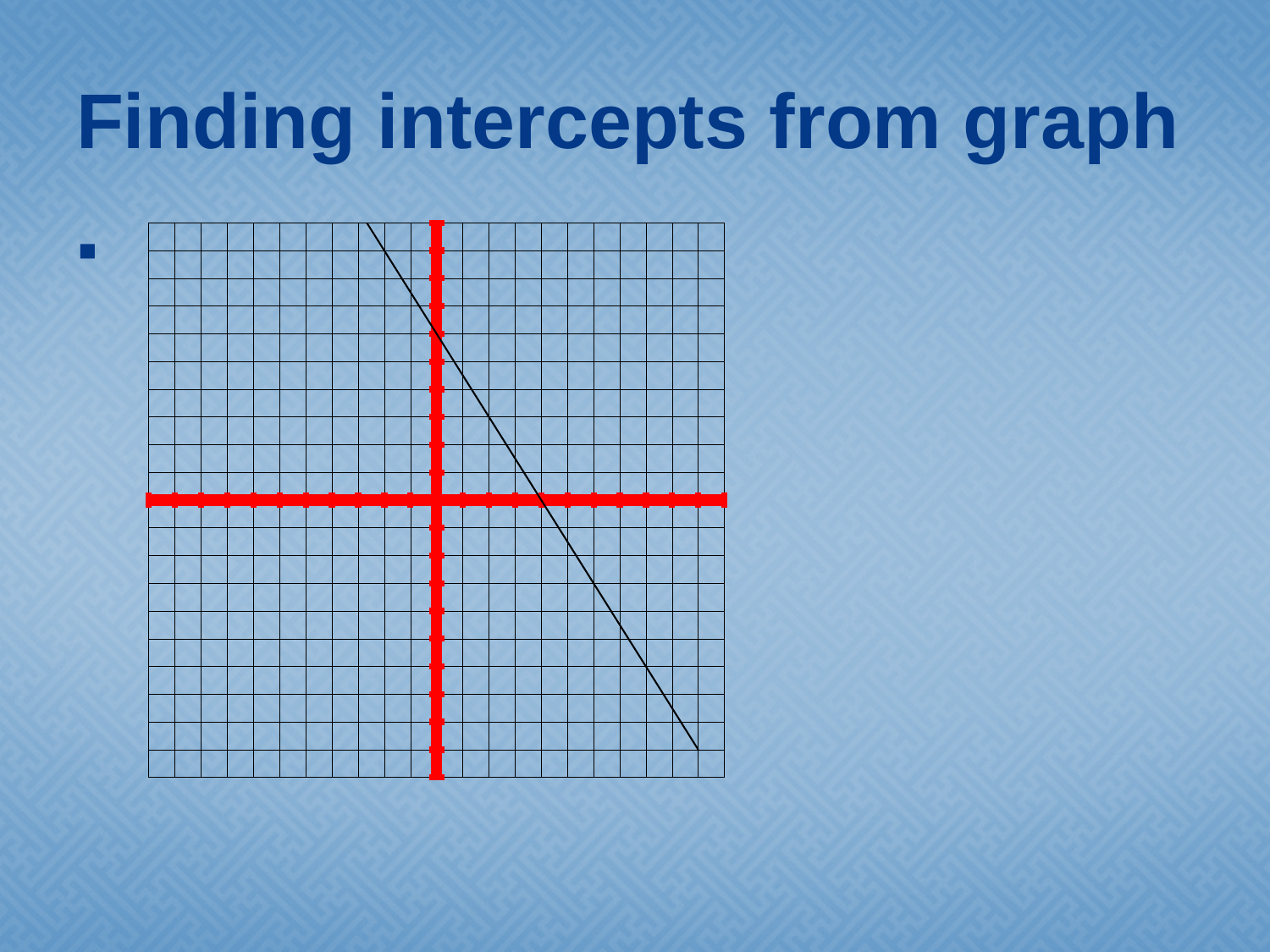
How many lines are plotted on the grid? 1 Does the plotted line rise or fall as you move from left to right along the x axis? fall What kind of chart is shown on the slide? line graph What colour are the x and y axes drawn in on the graph? red What is the title of the slide containing the graph? Finding intercepts from graph Does the plotted line cross the x axis to the left or to the right of the y axis? right Does the plotted line cross the y axis above or below the x axis? above